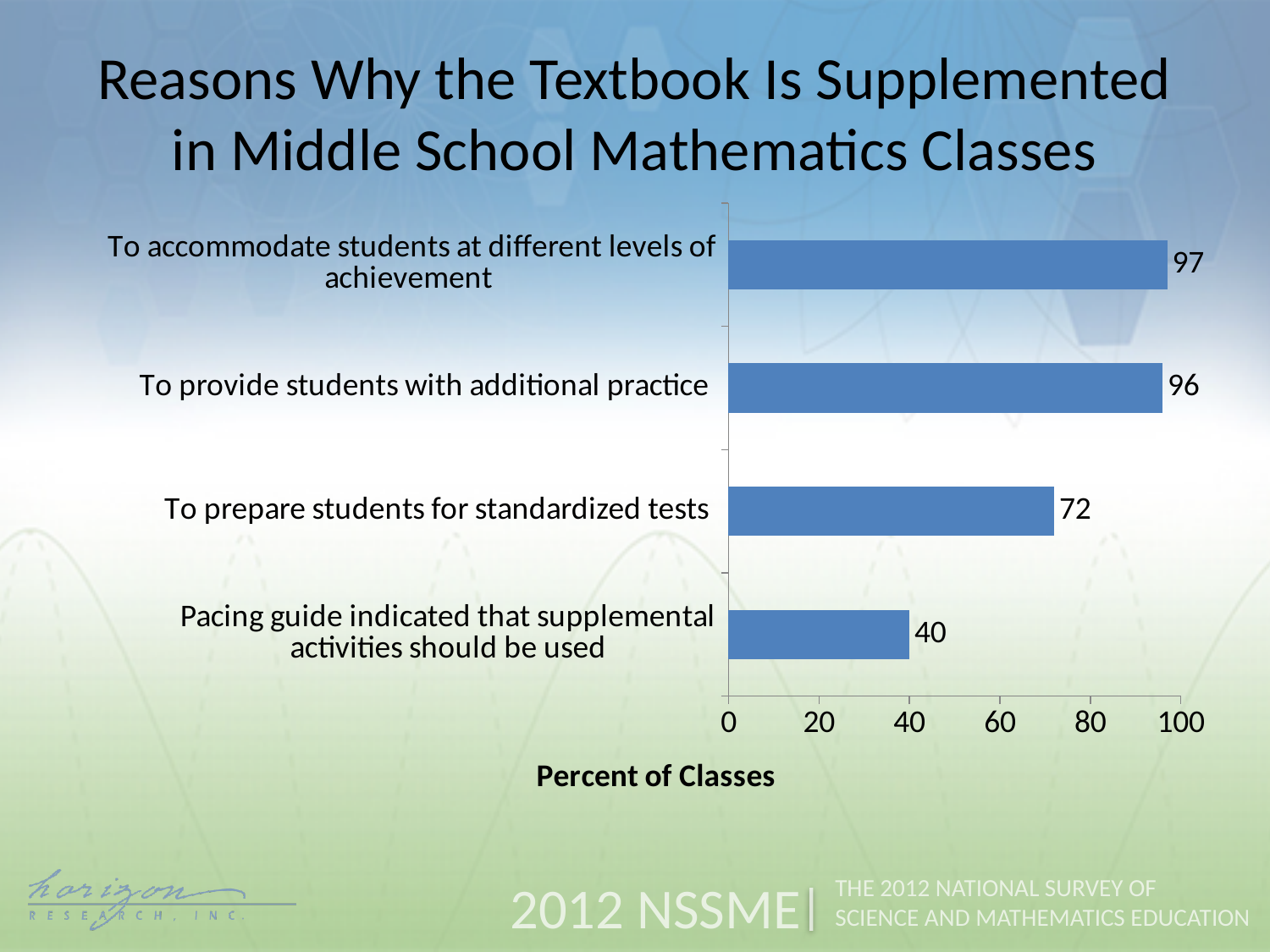
What is the value for 'Pacing guide indicated that supplemental activities should be used'? 40 What is the value for 'To provide students with additional practice'? 96 Which reason has the lowest percent of classes? Pacing guide indicated that supplemental activities should be used What is the label of the horizontal axis? Percent of Classes How many reasons are shown in the chart? 4 What kind of chart is shown on the slide? bar chart What is the difference between the values for 'To prepare students for standardized tests' and 'Pacing guide indicated that supplemental activities should be used'? 32 Is the value for 'To prepare students for standardized tests' greater or less than 60? greater Which reason has the highest percent of classes? To accommodate students at different levels of achievement What percent of classes supplement the textbook to accommodate students at different levels of achievement? 97 What percent of classes supplement the textbook to prepare students for standardized tests? 72 Which is larger: the value for 'To prepare students for standardized tests' or for 'To provide students with additional practice'? To provide students with additional practice